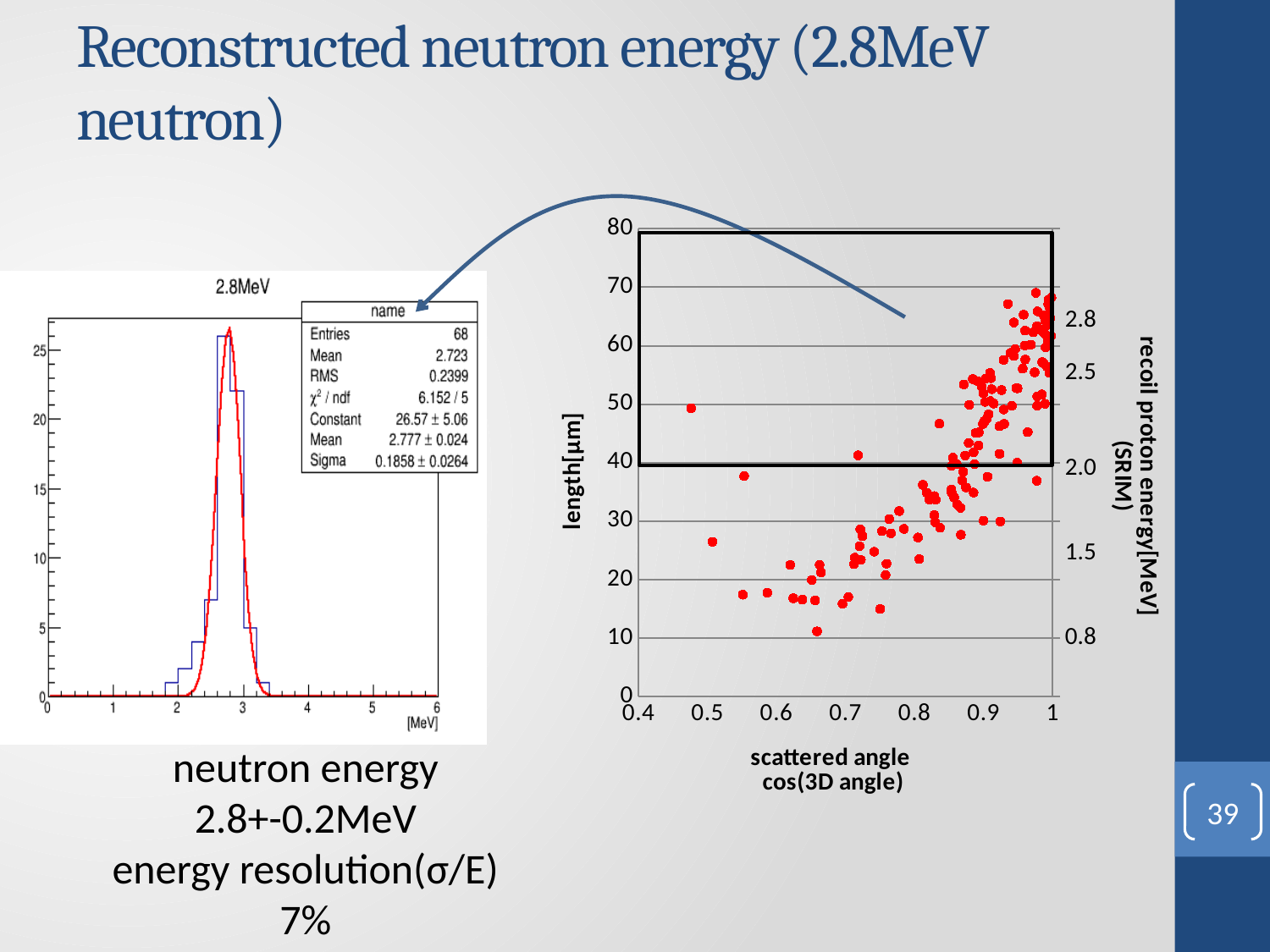
In the left-hand histogram's statistics box, what is the fitted Sigma? 0.1858 ± 0.0264 What kind of chart is the right-hand chart of length versus scattered angle? scatter plot In the right-hand chart, is the lowest point near cos(3D angle) = 0.66 greater or less than 20 μm? less In the left-hand histogram's statistics box, how many entries are there? 68 What is the title of the left-hand histogram? 2.8MeV In the right-hand chart, is the length of the isolated point near cos(3D angle) = 0.47 greater or less than 40 μm? greater In the left-hand histogram's statistics box, what is the RMS? 0.2399 In the left-hand histogram's statistics box, what is the χ² / ndf value? 6.152 / 5 What is the label of the secondary (right) vertical axis of the right-hand chart? recoil proton energy[MeV] (SRIM) In the left-hand histogram's statistics box, what is the fitted Constant? 26.57 ± 5.06 In the right-hand chart, how does the length[μm] change as cos(3D angle) increases from 0.4 to 1? it rises In the left-hand histogram's statistics box, what is the fitted Mean? 2.777 ± 0.024